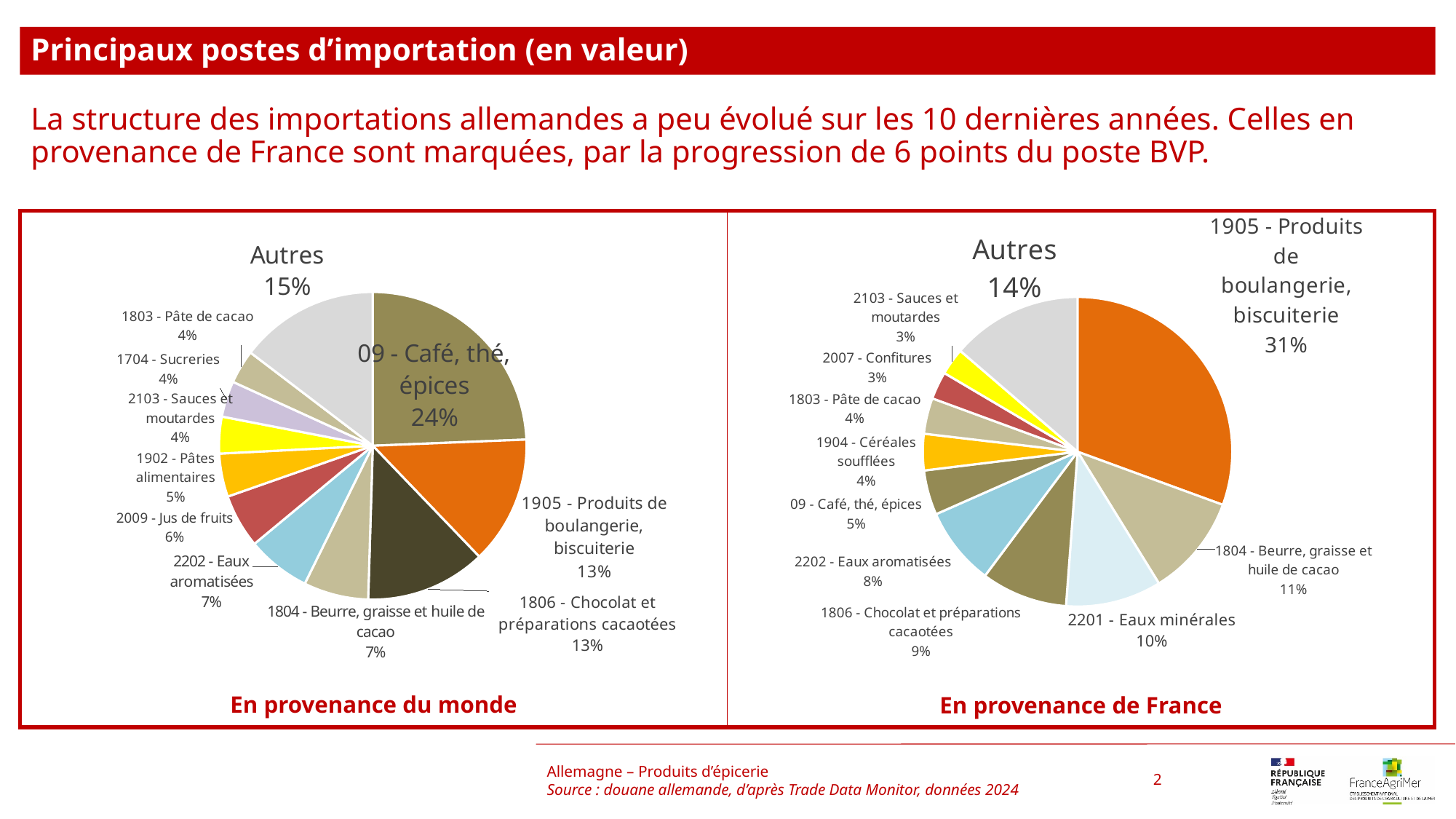
In the 'En provenance du monde' chart, what is the share of '2009 - Jus de fruits'? 6% In the 'En provenance du monde' chart, what share does '09 - Café, thé, épices' have? 24% In the 'En provenance de France' chart, what is the difference in share between '1905 - Produits de boulangerie, biscuiterie' and '1804 - Beurre, graisse et huile de cacao'? 20 percentage points In the 'En provenance du monde' chart, which named category (excluding 'Autres') has the largest share? 09 - Café, thé, épices In the 'En provenance de France' chart, what is the share of '2201 - Eaux minérales'? 10% In the 'En provenance du monde' chart, which is larger: the share of '2202 - Eaux aromatisées' or the share of '1902 - Pâtes alimentaires'? 2202 - Eaux aromatisées In the 'En provenance du monde' chart, what is the combined share of '1905 - Produits de boulangerie, biscuiterie' and '1806 - Chocolat et préparations cacaotées'? 26% In the 'En provenance de France' chart, what share does '1905 - Produits de boulangerie, biscuiterie' have? 31% What is the title of the slide containing the two pie charts? Principaux postes d’importation (en valeur) What type of chart is used for 'En provenance du monde'? Pie chart How many slices does the 'En provenance de France' pie chart have? 11 In the 'En provenance de France' chart, what is the share of 'Autres'? 14%